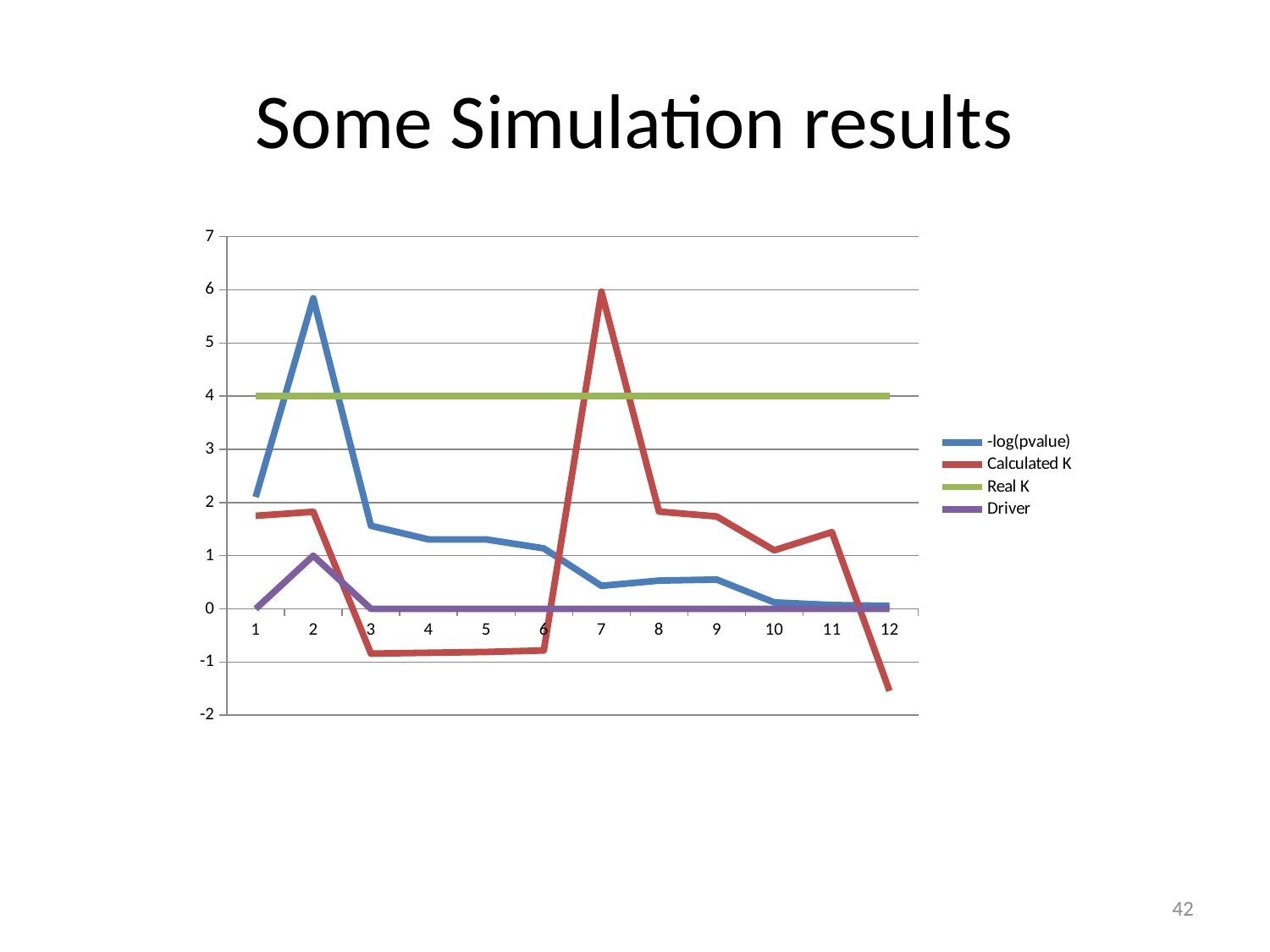
At point 7, which is larger: Calculated K or -log(pvalue)? Calculated K How many series does the legend list? 4 What is the value of Real K at point 5? 4 At which x-axis point does -log(pvalue) reach its highest value? 2 At which x-axis point is Calculated K lowest? 12 Which colour is used for the Real K series? green How many points are there along the x axis? 12 Is the value of -log(pvalue) at point 2 greater or less than 5? greater What is the value of Driver at point 6? 0 At which x-axis point does Calculated K reach its highest value? 7 What kind of chart is shown on the slide? line chart Is the value of Calculated K at point 4 greater or less than 0? less